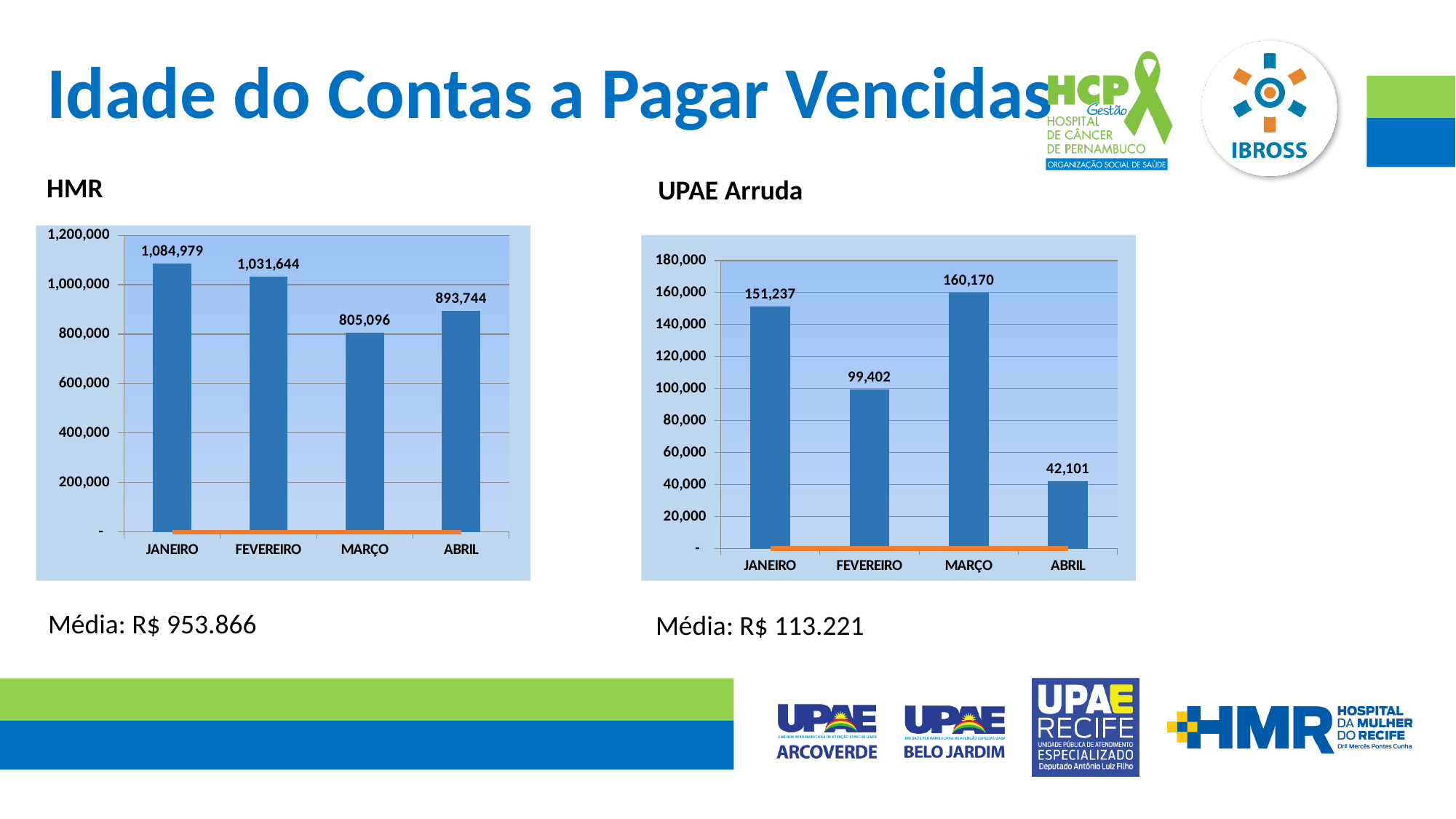
How many months are shown in the HMR chart? 4 In the UPAE Arruda chart, is the value for JANEIRO greater or less than 140,000? greater In the UPAE Arruda chart, which month has the highest value? MARÇO In the UPAE Arruda chart, what is the value for FEVEREIRO? 99,402 In the UPAE Arruda chart, which month has the lowest value? ABRIL What is the average (Média) shown below the HMR chart? R$ 953.866 In the HMR chart, what is the value for JANEIRO? 1,084,979 In the UPAE Arruda chart, what is the difference between the MARÇO and ABRIL values? 118,069 In the HMR chart, what is the difference between the JANEIRO and FEVEREIRO values? 53,335 In the HMR chart, which month has the lowest value? MARÇO What kind of chart is the UPAE Arruda chart? bar chart In the HMR chart, which is larger, the value for MARÇO or the value for ABRIL? ABRIL